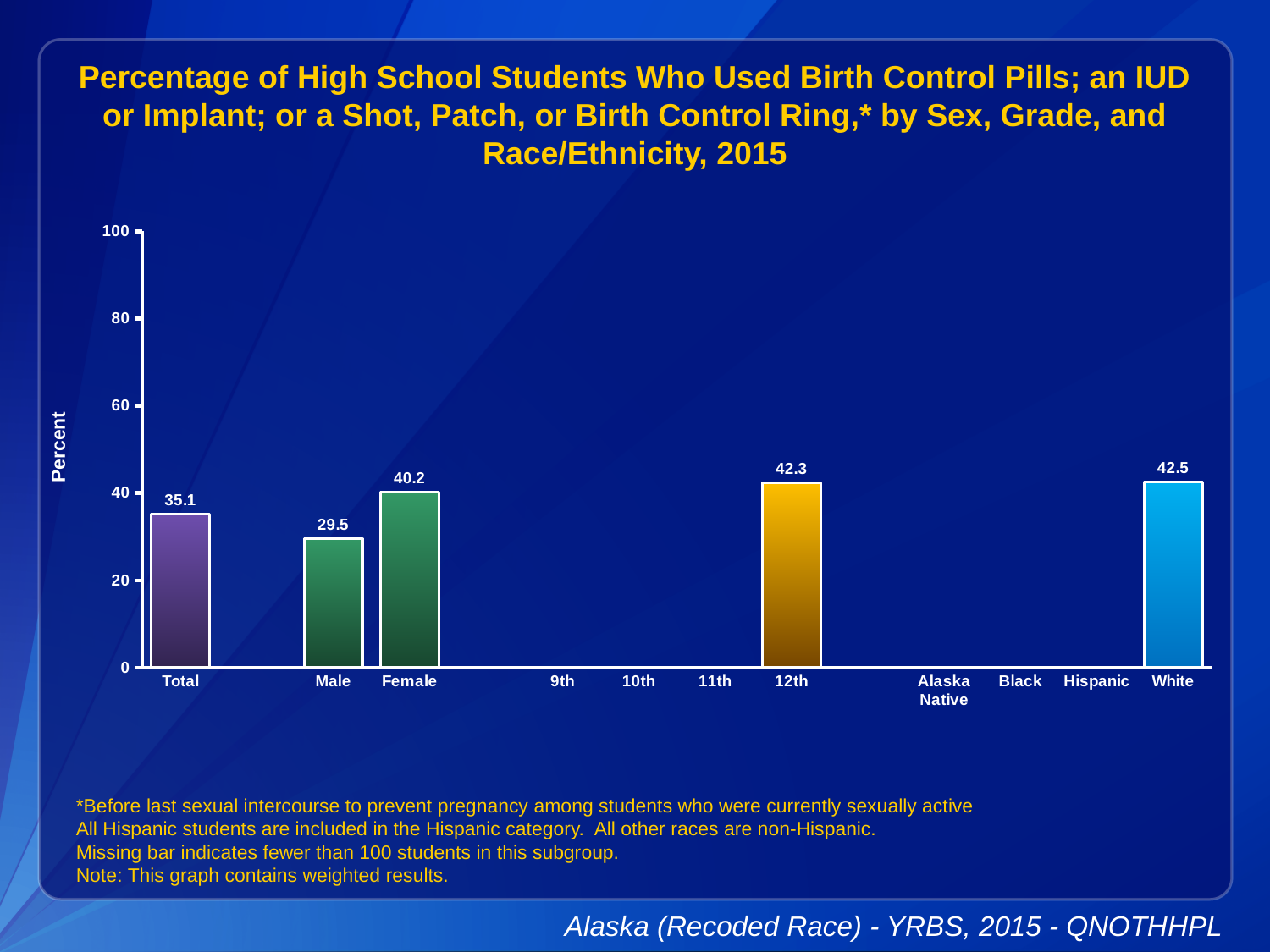
How many category labels are shown on the x axis? 11 What is the difference between the Female and Male values? 10.7 Which is larger, the value for Male or the value for Female? Female Is the value for Total greater or less than 40? less How many bars are plotted on the chart? 5 What is the value for 12th grade? 42.3 Which category has the lowest plotted value? Male What is the label on the y axis? Percent What is the value for Total? 35.1 What kind of chart is shown on the slide? bar chart What is the value for White? 42.5 What is the value for Female? 40.2